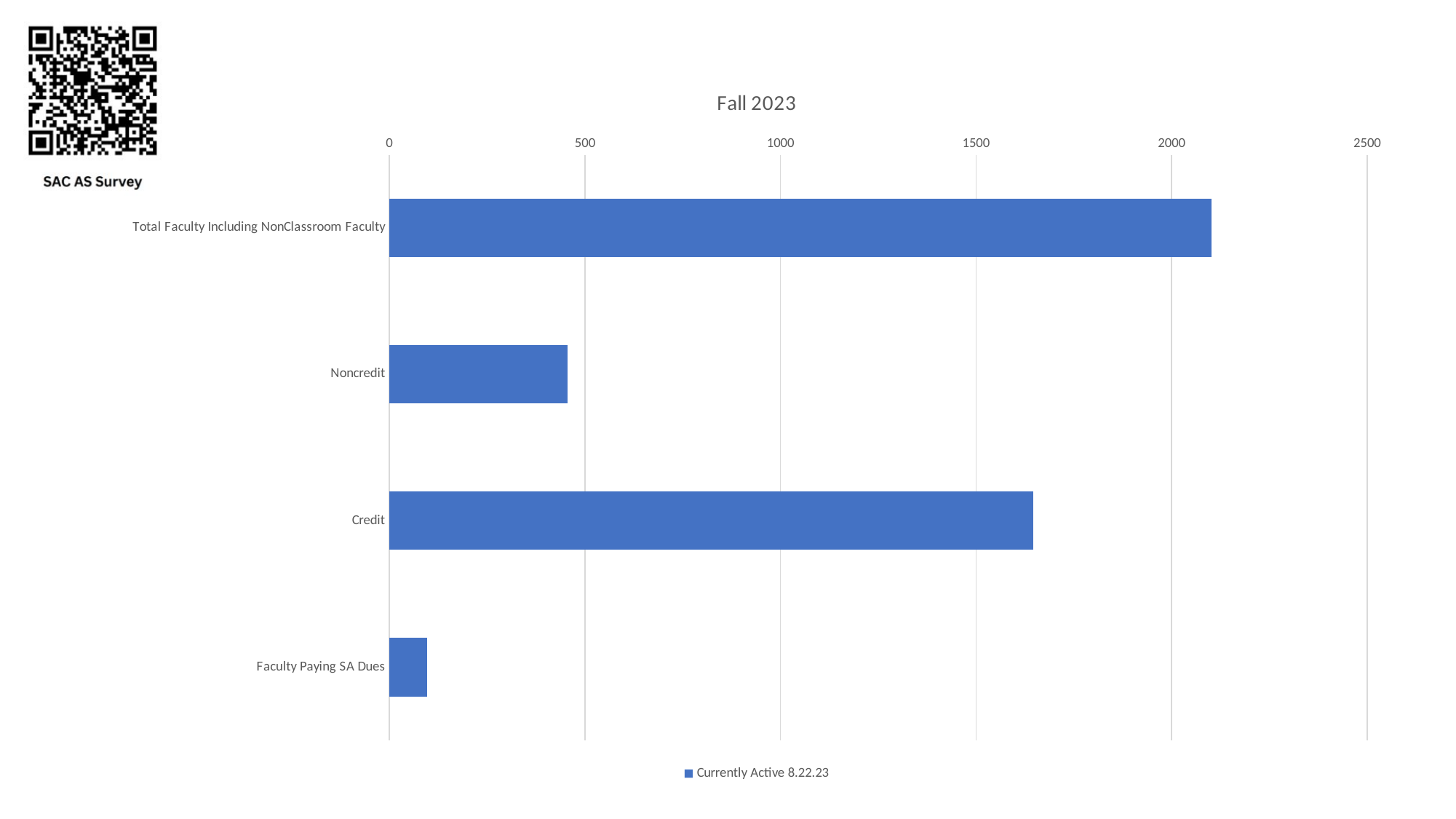
What type of chart is shown on the slide? bar chart What is the name of the series shown in the legend? Currently Active 8.22.23 Which is larger, the value for Credit or the value for Noncredit? Credit How many series does the legend list? 1 What is the title of the chart? Fall 2023 Which category has the highest value? Total Faculty Including NonClassroom Faculty Is the value for Faculty Paying SA Dues greater or less than 500? less Which category has the lowest value? Faculty Paying SA Dues How many categories are plotted in the chart? 4 Is the value for Noncredit greater or less than 500? less Is the value for Total Faculty Including NonClassroom Faculty greater or less than 2000? greater